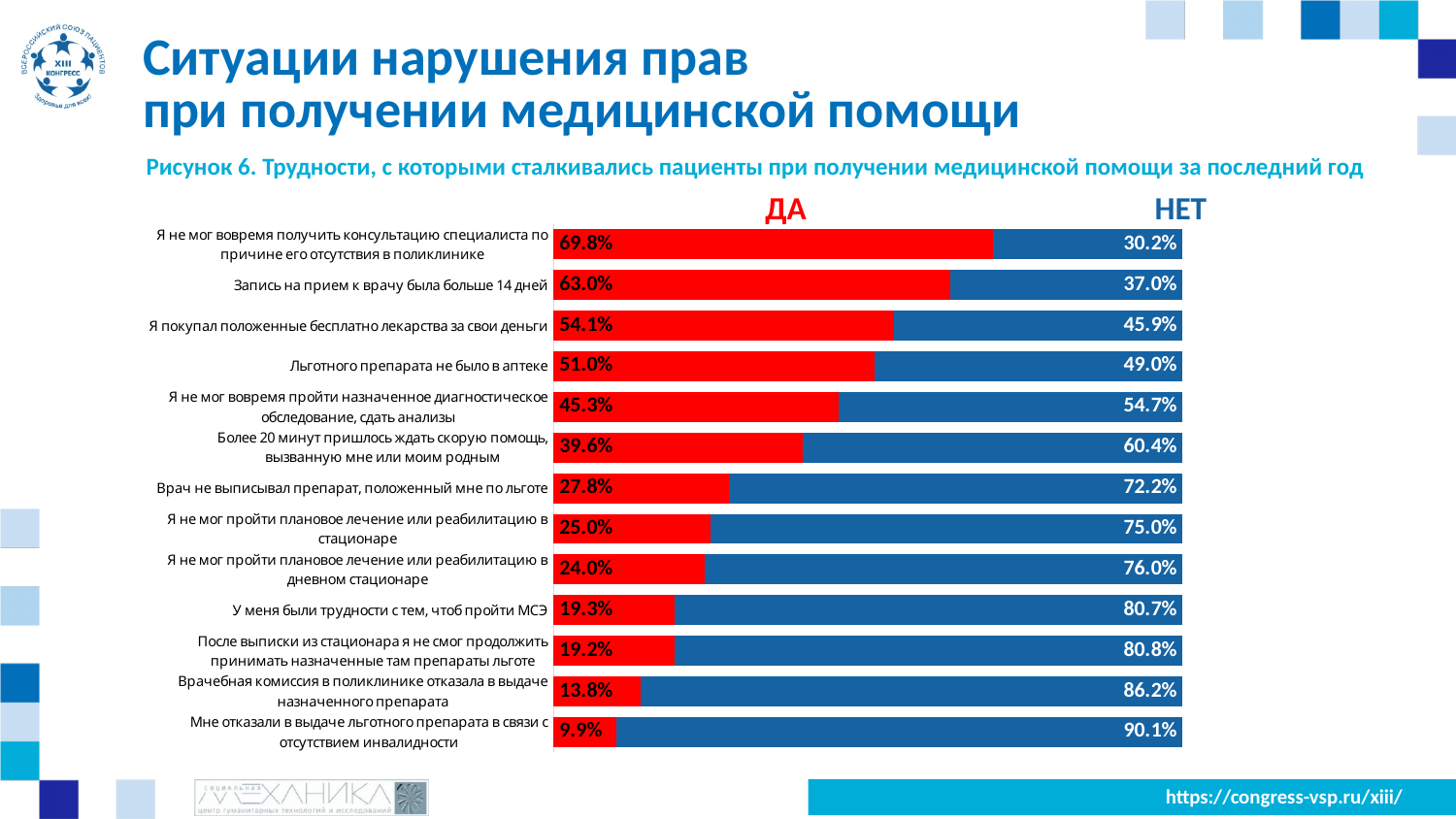
What is the total of the "ДА" and "НЕТ" values for "Более 20 минут пришлось ждать скорую помощь, вызванную мне или моим родным"? 100.0% What colour represents the "ДА" answers in the chart? Red Which difficulty has the highest "ДА" share? Я не мог вовремя получить консультацию специалиста по причине его отсутствия в поликлинике Which difficulty has the lowest "ДА" share? Мне отказали в выдаче льготного препарата в связи с отсутствием инвалидности What is the "НЕТ" value for "Я покупал положенные бесплатно лекарства за свои деньги"? 45.9% How many difficulties (categories) are shown in the chart? 13 What is the "НЕТ" value for "Я не мог вовремя пройти назначенное диагностическое обследование, сдать анализы"? 54.7% How many series does the chart show? 2 What type of chart is shown on the slide? Stacked bar chart Which has a larger "ДА" value: "У меня были трудности с тем, чтоб пройти МСЭ" or "Врачебная комиссия в поликлинике отказала в выдаче назначенного препарата"? У меня были трудности с тем, чтоб пройти МСЭ What is the difference between the "ДА" values for "Льготного препарата не было в аптеке" and "Врач не выписывал препарат, положенный мне по льготе"? 23.2% What percentage of patients answered "ДА" to "Запись на прием к врачу была больше 14 дней"? 63.0%